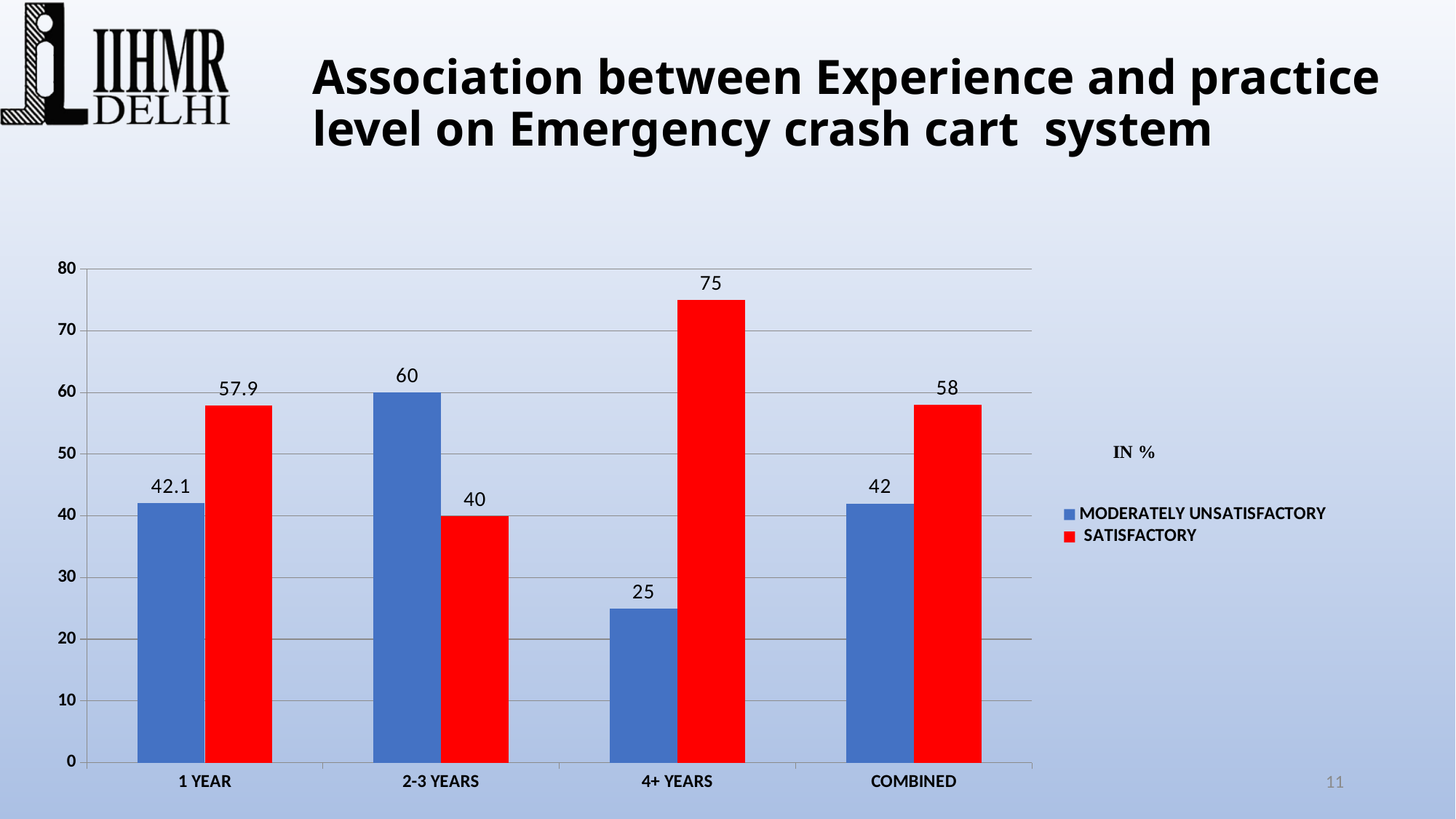
For 1 YEAR, which is larger: MODERATELY UNSATISFACTORY or SATISFACTORY? SATISFACTORY How many experience categories are shown on the x axis? 4 How many series does the legend list? 2 What kind of chart is shown on the slide? bar chart Which colour represents the SATISFACTORY series? red What is the MODERATELY UNSATISFACTORY value for 1 YEAR? 42.1 What is the difference between the SATISFACTORY and MODERATELY UNSATISFACTORY values for 2-3 YEARS? 20 What is the SATISFACTORY value for COMBINED? 58 Is the MODERATELY UNSATISFACTORY value for 2-3 YEARS greater or less than 50? greater Which experience category has the highest SATISFACTORY value? 4+ YEARS Which experience category has the lowest MODERATELY UNSATISFACTORY value? 4+ YEARS What is the SATISFACTORY value for 4+ YEARS? 75